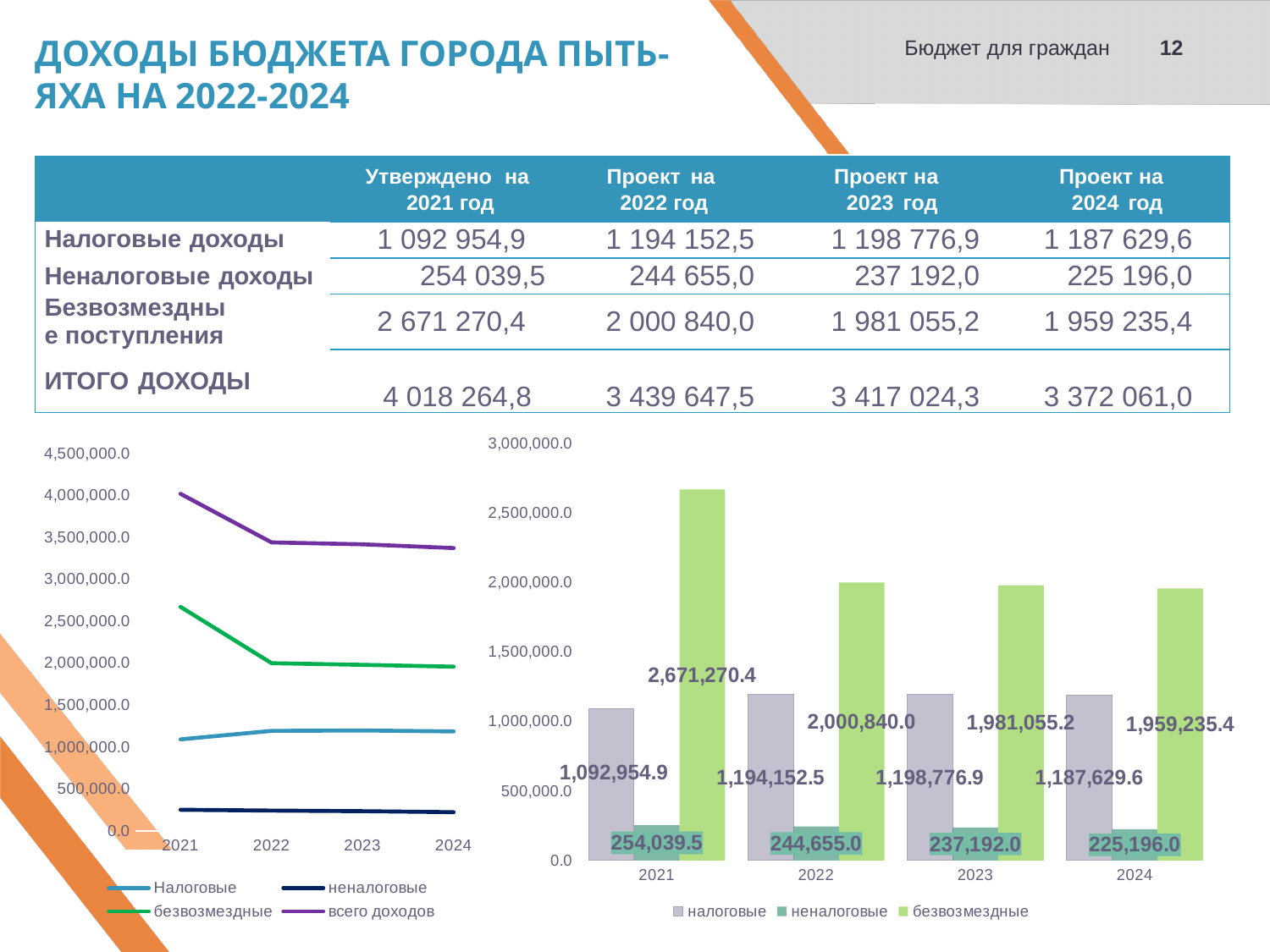
On the right bar chart, in which year is the безвозмездные bar highest? 2021 On the right bar chart, what is the value of неналоговые for 2024? 225,196.0 On the left line chart, is the value of всего доходов for 2021 greater or less than 3,500,000.0? greater On the right bar chart, what is the value of безвозмездные for 2021? 2,671,270.4 What kind of chart is the chart on the left of the slide? line chart On the right bar chart, what is the value of налоговые for 2023? 1,198,776.9 On the right bar chart, in which year is the неналоговые bar lowest? 2024 On the left line chart, how many series does the legend list? 4 On the left line chart, does the безвозмездные line rise or fall from 2021 to 2024? fall On the right bar chart, how many series does the legend list? 3 On the right bar chart, which is larger in 2022: налоговые or безвозмездные? безвозмездные On the right bar chart, what is the difference between безвозмездные in 2021 and in 2022? 670,430.4